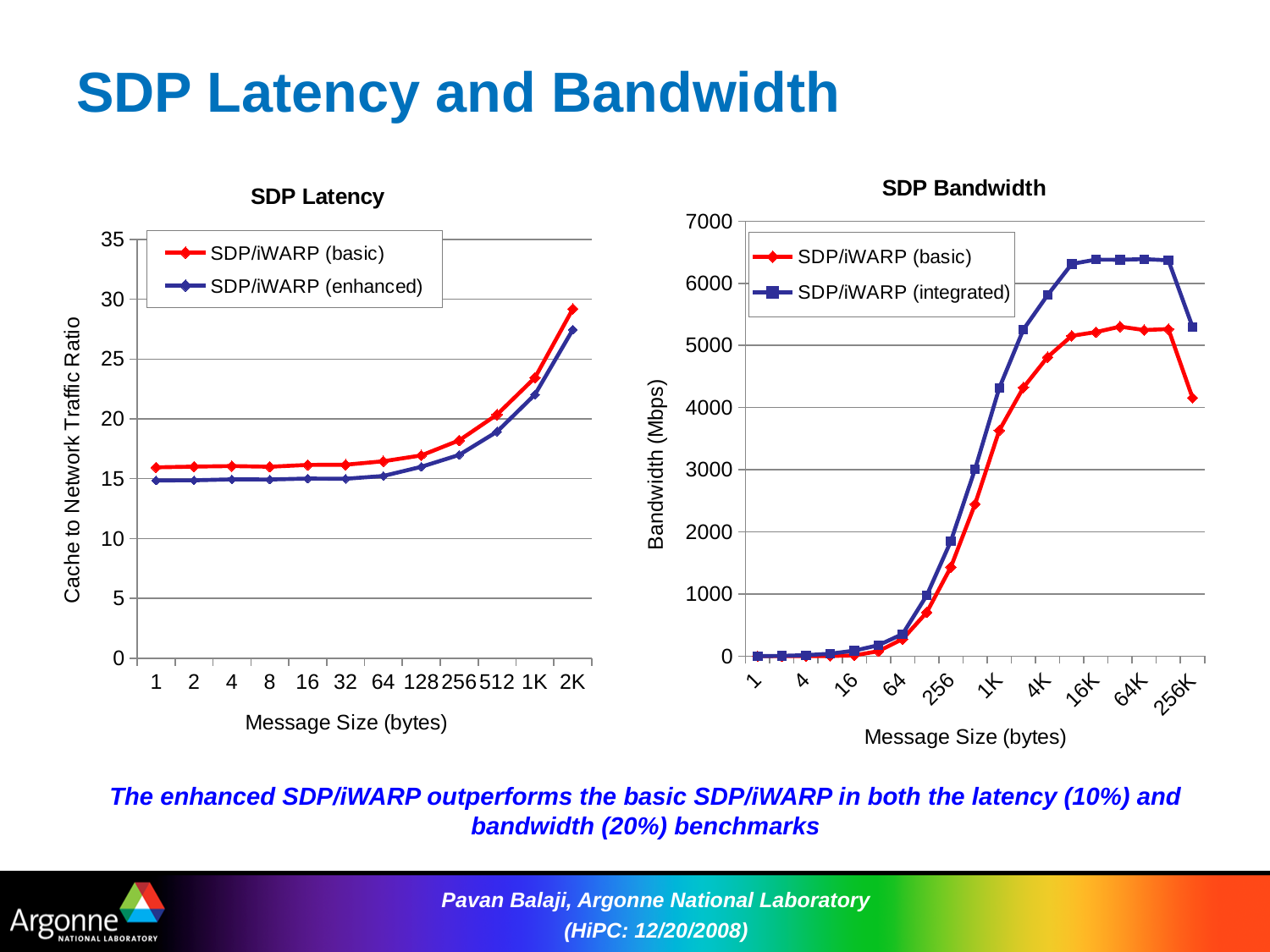
In the SDP Latency chart, is the value for SDP/iWARP (enhanced) at message size 1 greater or less than 20? less In the SDP Bandwidth chart, is the value for SDP/iWARP (integrated) at message size 64K greater or less than 6000? greater In the SDP Latency chart, do the values rise or fall as message size increases? rise What colour is the SDP/iWARP (basic) line in the SDP Latency chart? red In the SDP Latency chart, is the value for SDP/iWARP (basic) at message size 2K greater or less than 25? greater How many message sizes are shown on the x axis of the SDP Latency chart? 12 How many series does the legend of the SDP Bandwidth chart list? 2 What type of chart is the SDP Latency chart? line chart In the SDP Latency chart, which series has the higher value at message size 2K, SDP/iWARP (basic) or SDP/iWARP (enhanced)? SDP/iWARP (basic) In the SDP Bandwidth chart, which series has the higher value at message size 256K, SDP/iWARP (basic) or SDP/iWARP (integrated)? SDP/iWARP (integrated) What is the y-axis label of the SDP Bandwidth chart? Bandwidth (Mbps)